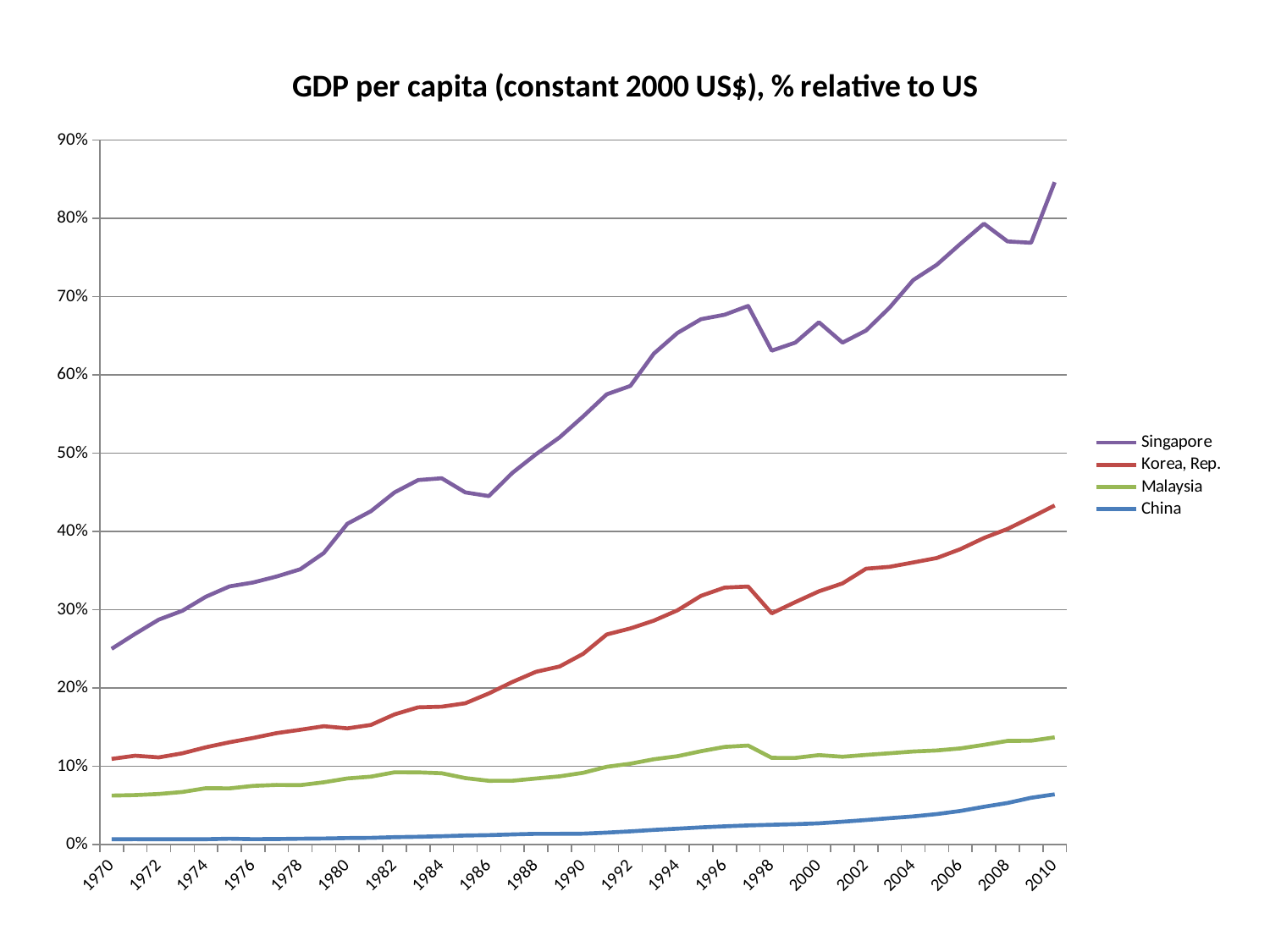
Is the value for China in 2010 greater or less than 10%? less Which is larger in 2010, the value for Korea, Rep. or the value for Malaysia? Korea, Rep. Which series has the highest values across the whole period? Singapore Does the Singapore line generally rise or fall from 1970 to 2010? rise Is the value for Korea, Rep. in 2010 greater or less than 40%? greater Is the value for Singapore in 2010 greater or less than 80%? greater How many series does the legend list? 4 What kind of chart is shown on the slide? line chart Which series has the lowest values across the whole period? China What is the title of the chart? GDP per capita (constant 2000 US$), % relative to US